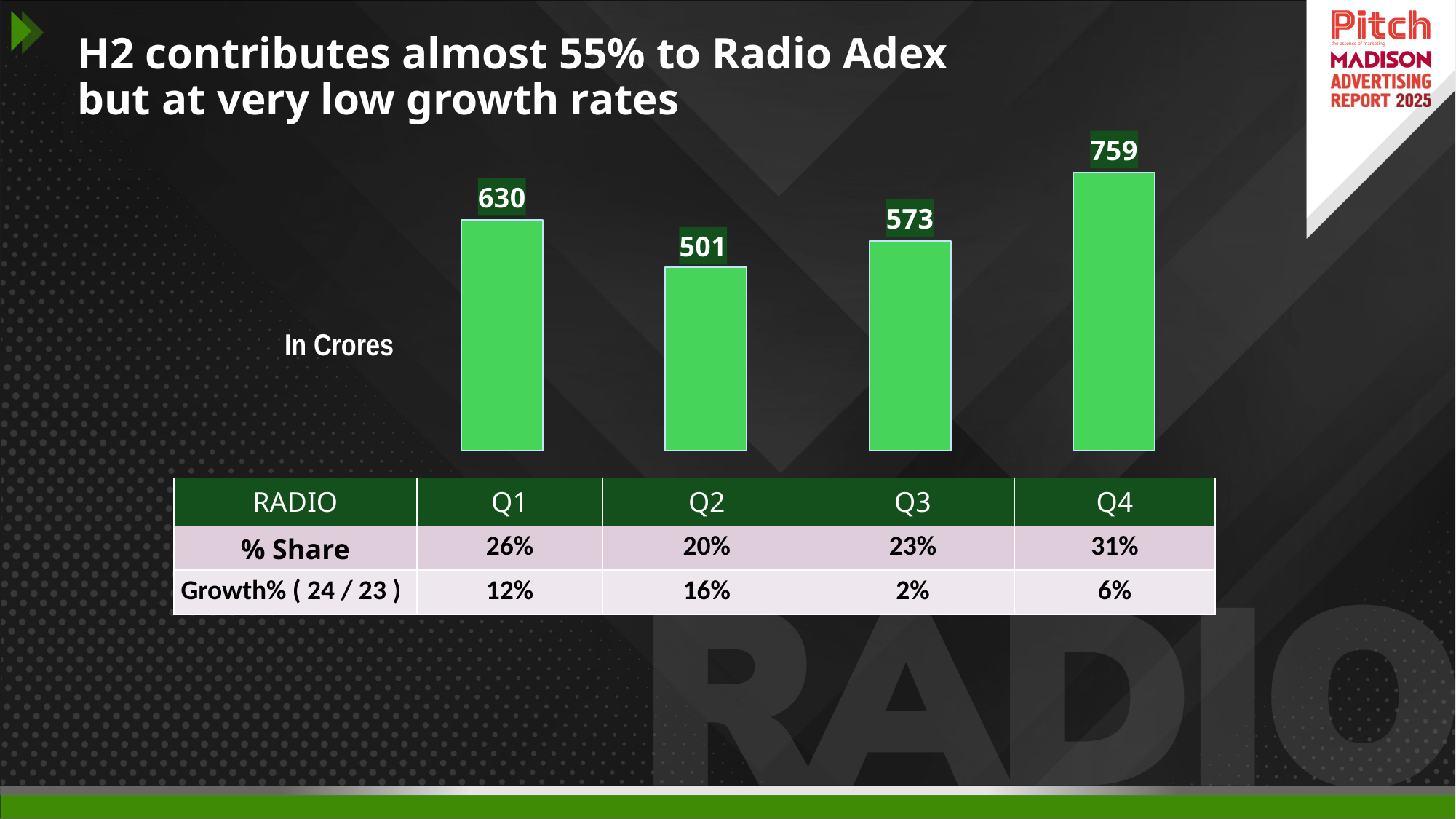
What unit are the bar values expressed in, according to the label next to the chart? In Crores What is the Radio Adex value for Q2 in crores? 501 What is the Radio Adex value for Q1 in crores? 630 What kind of chart is shown on the slide? Bar chart What is the Radio Adex value for Q4 in crores? 759 Which quarter has the lowest Radio Adex value? Q2 What is the Radio Adex value for Q3 in crores? 573 What is the difference in crores between the Q1 and Q2 Radio Adex values? 129 How many quarters are plotted in the bar chart? 4 Which quarter has the highest Radio Adex value? Q4 What is the difference in crores between the Q4 and Q2 Radio Adex values? 258 Which is larger, the Radio Adex value for Q1 or for Q3? Q1